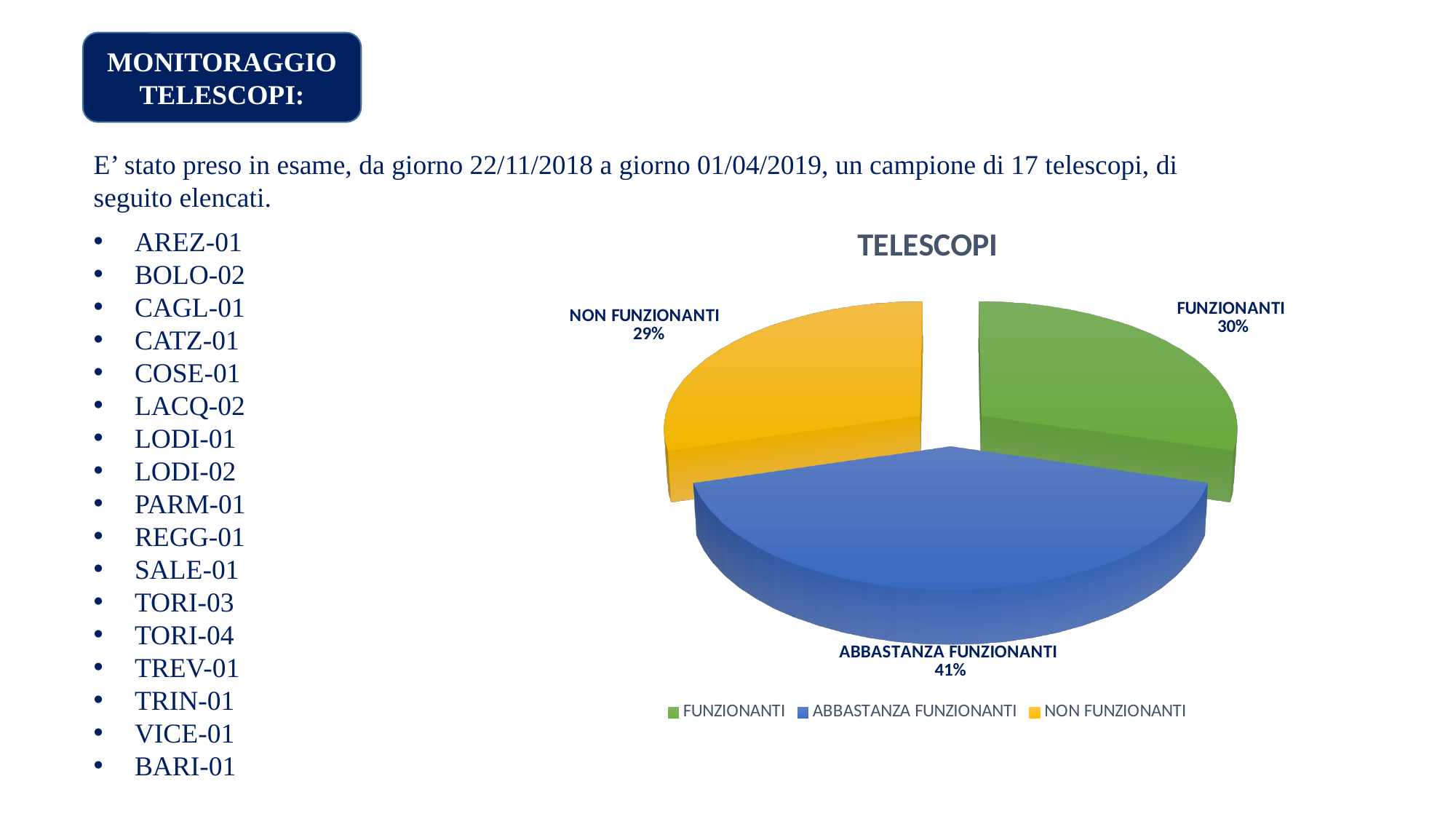
What percentage of the pie is NON FUNZIONANTI? 29% How many entries does the legend list? 3 What percentage of the pie is ABBASTANZA FUNZIONANTI? 41% What is the title of the chart? TELESCOPI What type of chart is shown on the slide? pie chart How many slices does the pie chart have? 3 Which category has the largest share of the pie? ABBASTANZA FUNZIONANTI Which category has the smallest share of the pie? NON FUNZIONANTI What percentage of the pie is FUNZIONANTI? 30% What is the difference in percentage points between FUNZIONANTI and NON FUNZIONANTI? 1 Which colour represents NON FUNZIONANTI in the chart? yellow What is the difference in percentage points between ABBASTANZA FUNZIONANTI and FUNZIONANTI? 11